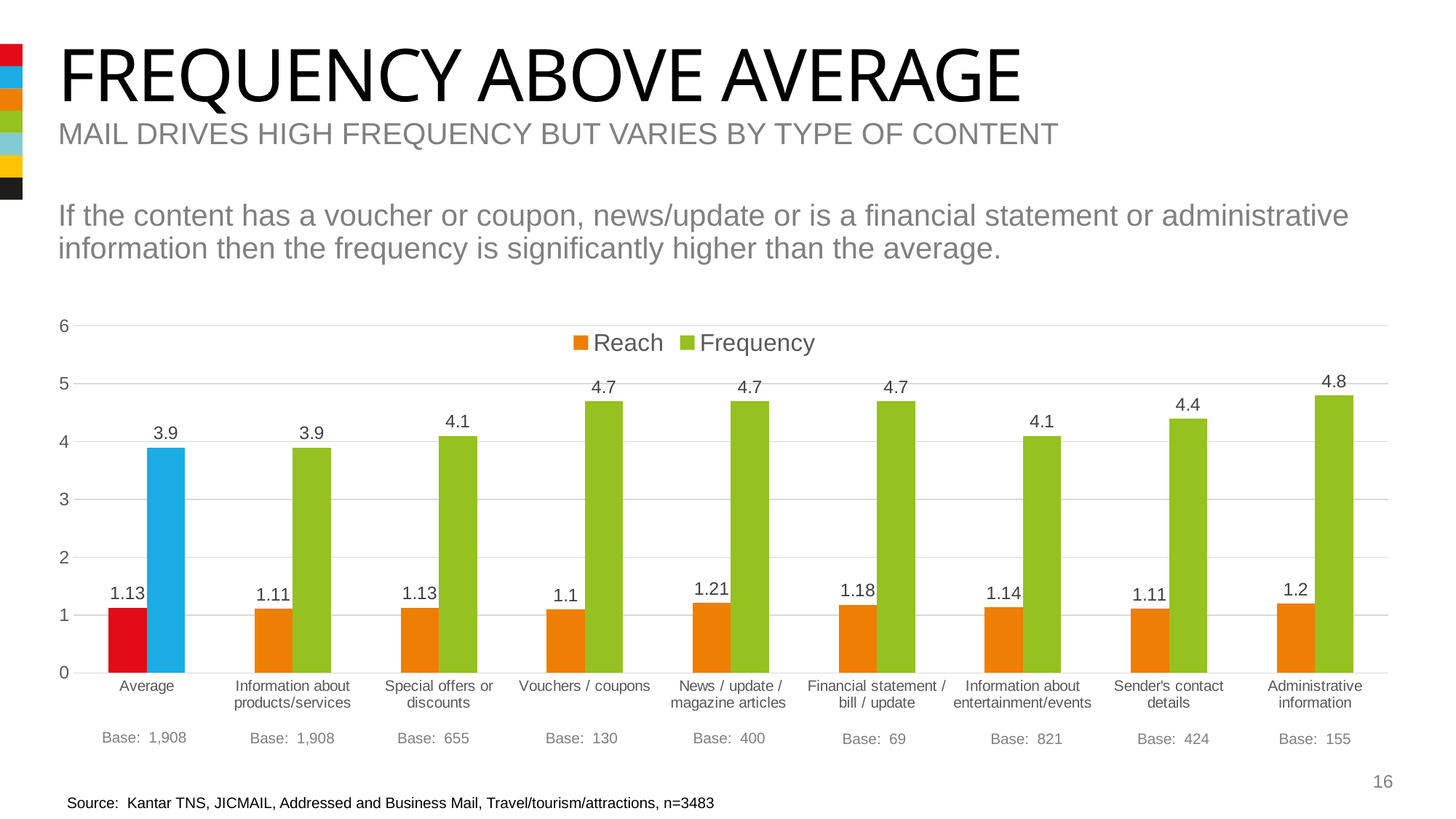
Which is larger, the Reach value for Financial statement / bill / update or the Reach value for Sender's contact details? Financial statement / bill / update Which category has the highest Frequency value? Administrative information What is the Frequency value for Average? 3.9 Is the Frequency value for Sender's contact details greater or less than 4? greater What is the difference between the Frequency values for Administrative information and Average? 0.9 What kind of chart is shown on the slide? Bar chart How many categories are shown on the x axis? 9 Which category has the lowest Reach value? Vouchers / coupons What is the Reach value for News / update / magazine articles? 1.21 What is the base shown for Vouchers / coupons? 130 What is the Frequency value for Administrative information? 4.8 How many series does the legend list? 2